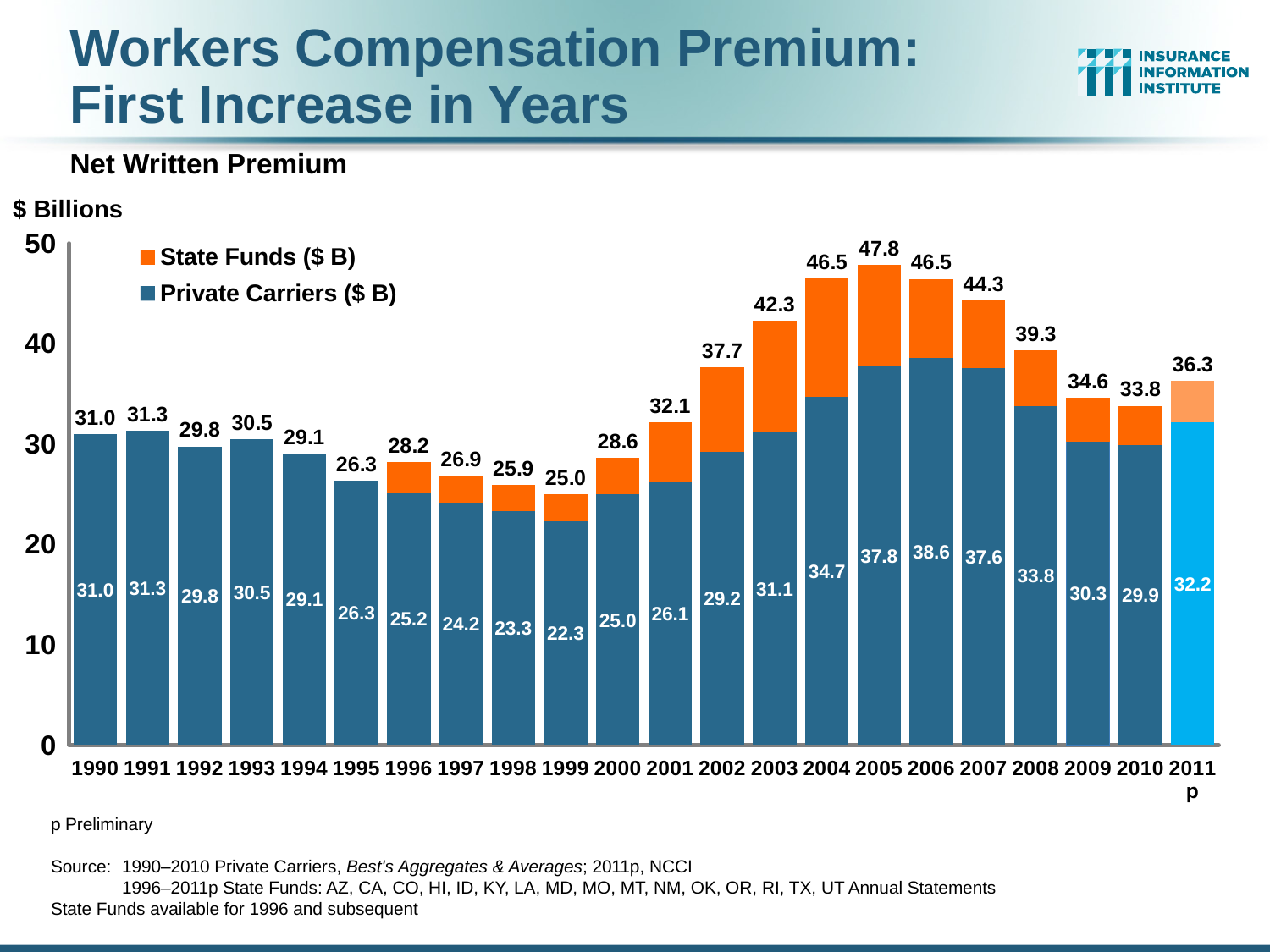
What type of chart is shown? Stacked bar chart What was the state funds portion of net written premium in 2011p (total minus private carriers)? 4.1 Was the total net written premium higher in 2003 or in 2008? 2003 What unit is shown on the y axis? $ Billions Did the total net written premium rise or fall from 2005 to 2010? Fall Which year had the lowest private carriers' net written premium? 1999 Which year had the highest total net written premium? 2005 What was the private carriers' net written premium in 1999? 22.3 What was the total net written premium in 2005? 47.8 How many years are shown on the x axis? 22 How much did the total net written premium increase from 2010 to 2011p? 2.5 How many series does the legend list? 2